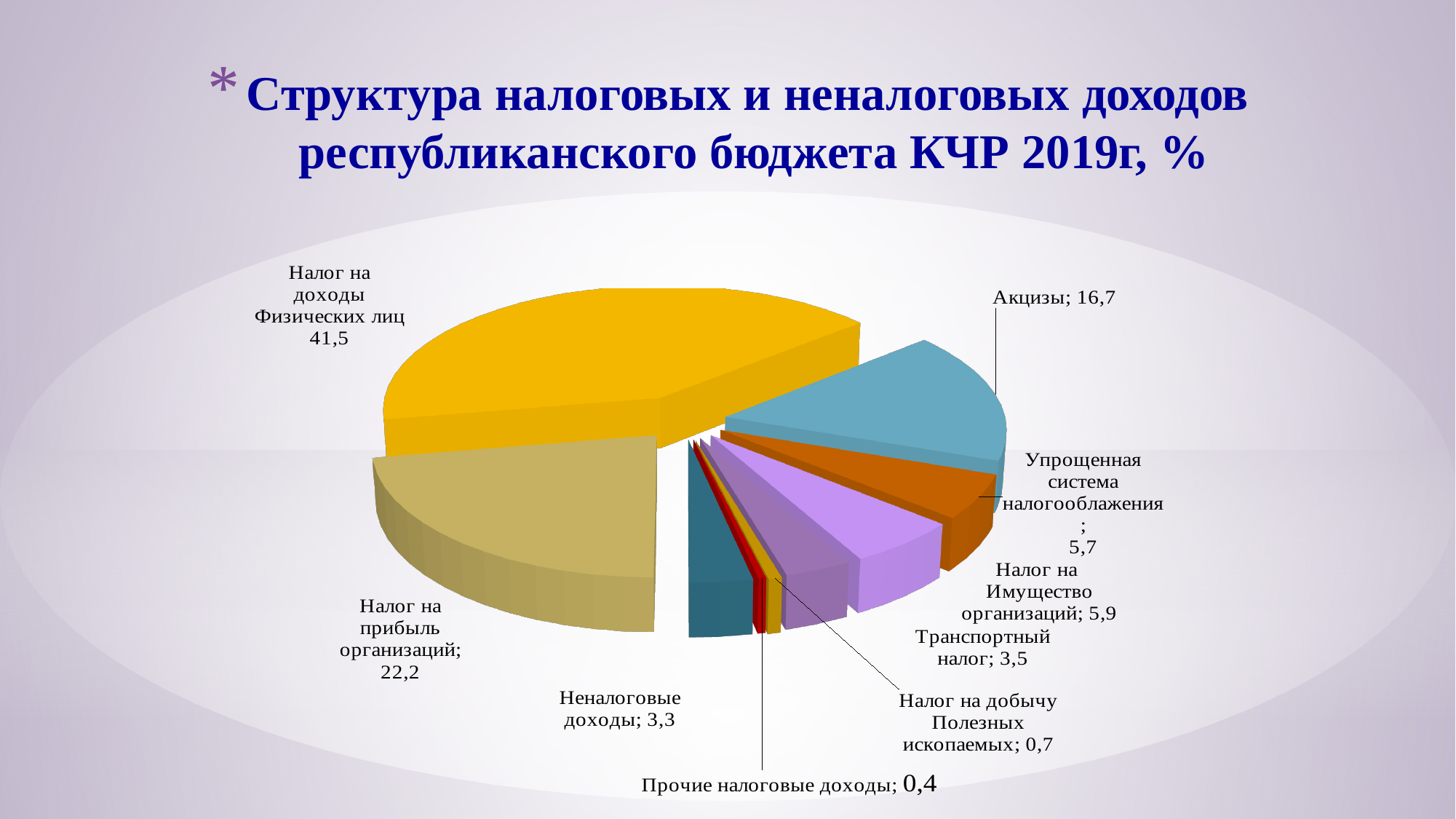
What is the value for Налог на доходы физических лиц? 41,5 What type of chart is shown on the slide? pie chart Which is larger: Акцизы or Налог на имущество организаций? Акцизы Which category has the largest slice of the pie? Налог на доходы физических лиц What is the title of the slide? Структура налоговых и неналоговых доходов республиканского бюджета КЧР 2019г, % How many slices does the pie chart have? 9 What is the difference between the values for Налог на доходы физических лиц and Налог на прибыль организаций? 19,3 What is the value for Упрощенная система налогообложения? 5,7 What is the value for Акцизы? 16,7 Which category has the smallest slice of the pie? Прочие налоговые доходы What is the value for Транспортный налог? 3,5 What is the value for Налог на прибыль организаций? 22,2